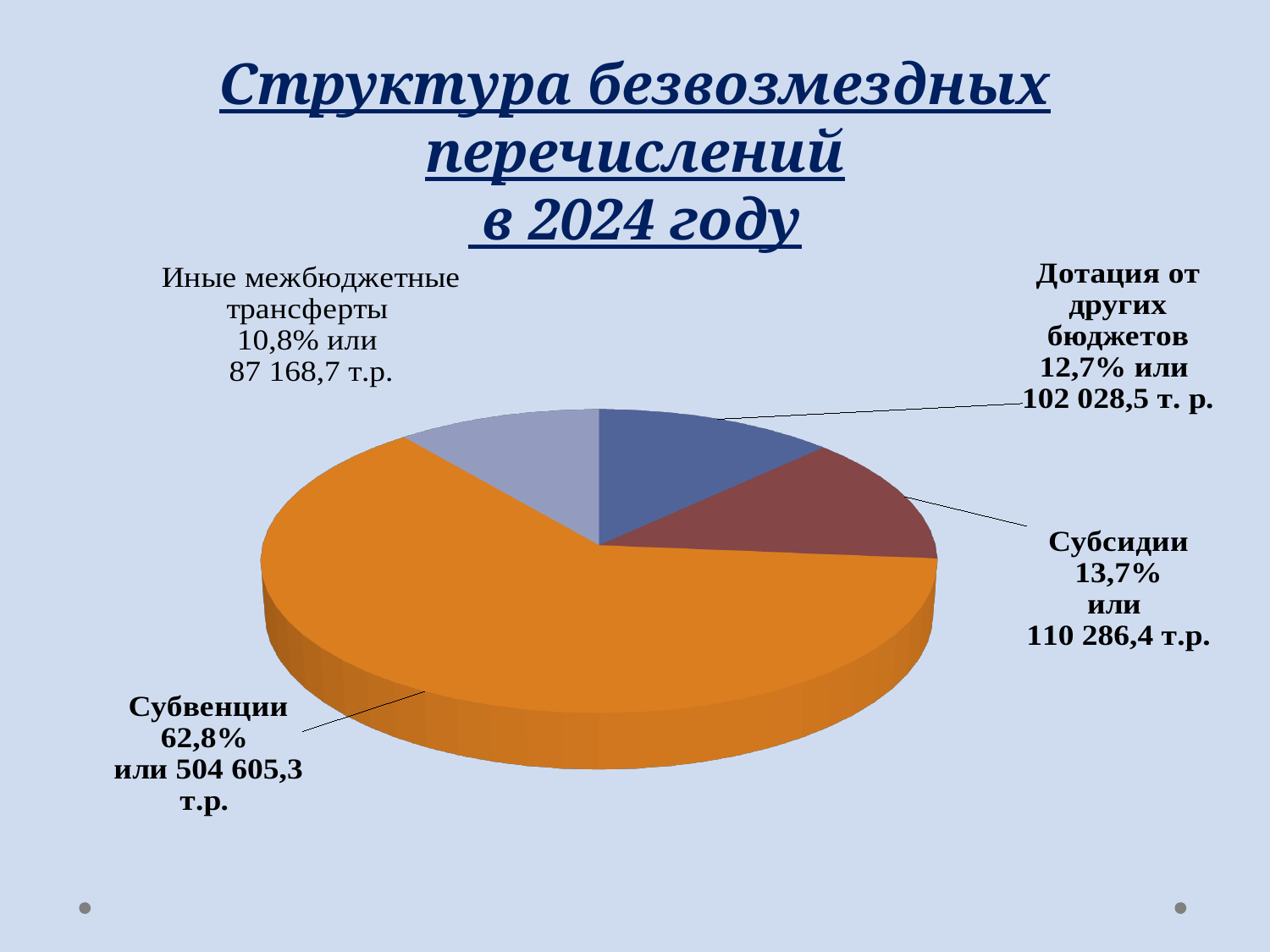
How many slices does the pie chart have? 4 What share of the pie does Субвенции account for? 62,8% What percentage is shown for Иные межбюджетные трансферты? 10,8% What is the amount shown for Субсидии? 110 286,4 т.р. What kind of chart is shown on the slide? Pie chart Which is larger, the share for Субсидии or the share for Дотация от других бюджетов? Субсидии Which category has the largest share of the pie? Субвенции What is the difference in percentage points between Субсидии (13,7%) and Дотация от других бюджетов (12,7%)? 1,0 What is the difference in percentage points between Субвенции (62,8%) and Субсидии (13,7%)? 49,1 What is the title of the chart on the slide? Структура безвозмездных перечислений в 2024 году What is the amount shown for Дотация от других бюджетов? 102 028,5 т. р. Which category has the smallest share of the pie? Иные межбюджетные трансферты